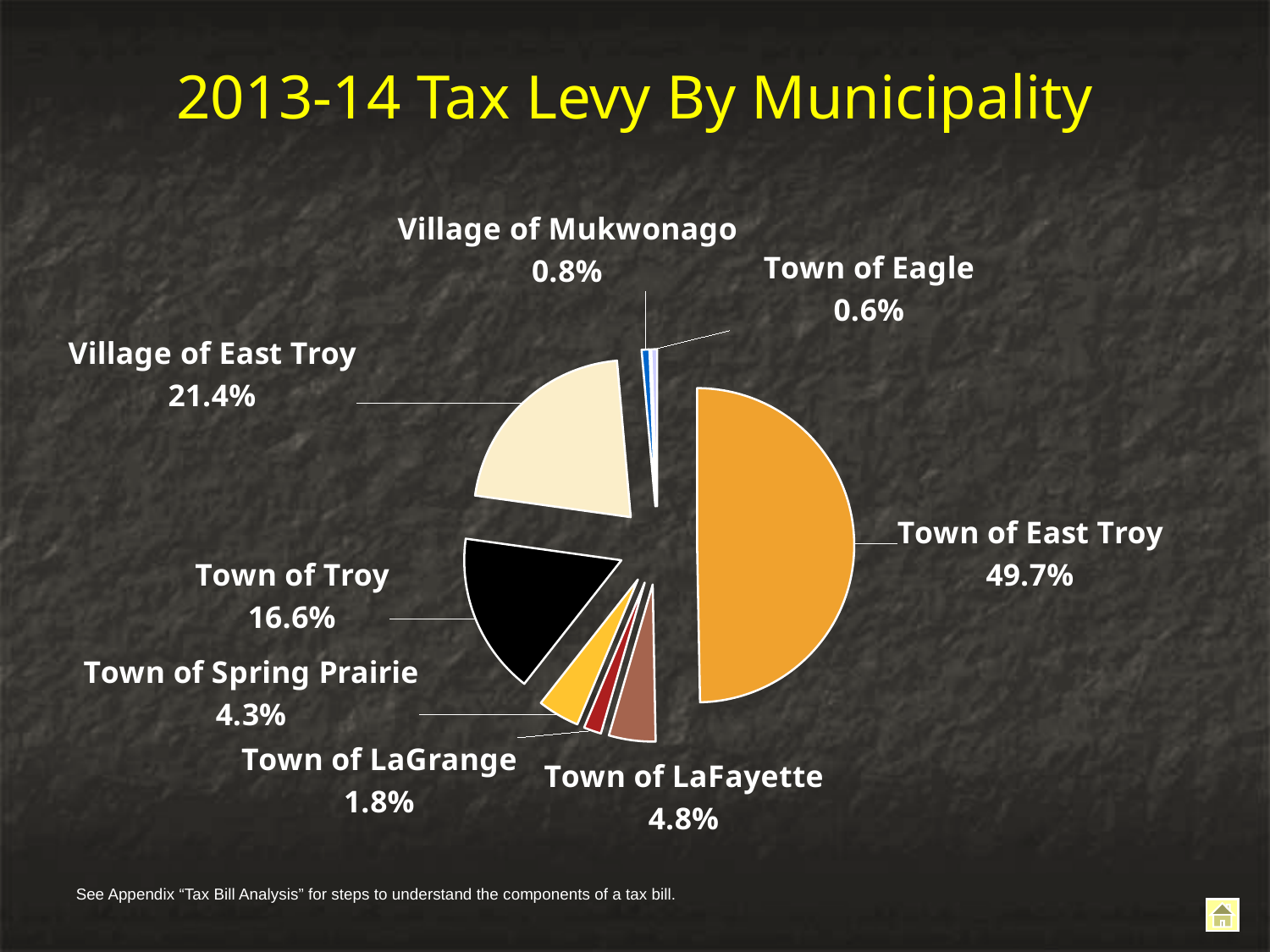
What is the title of the chart on this slide? 2013-14 Tax Levy By Municipality What percentage is shown for the Town of Spring Prairie? 4.3% What is the difference in percentage points between the Town of East Troy and the Village of East Troy? 28.3 What share does the Town of LaFayette contribute to the tax levy? 4.8% What is the value shown for the Town of Troy? 16.6% Which has a larger share of the tax levy, the Town of LaFayette or the Town of Spring Prairie? Town of LaFayette What type of chart is used on this slide? Pie chart Which municipality has the largest share of the 2013-14 tax levy? Town of East Troy How many municipalities are shown in the pie chart? 8 Which municipality has the smallest share of the tax levy? Town of Eagle What share of the 2013-14 tax levy comes from the Town of East Troy? 49.7% What percentage of the tax levy is attributed to the Village of East Troy? 21.4%